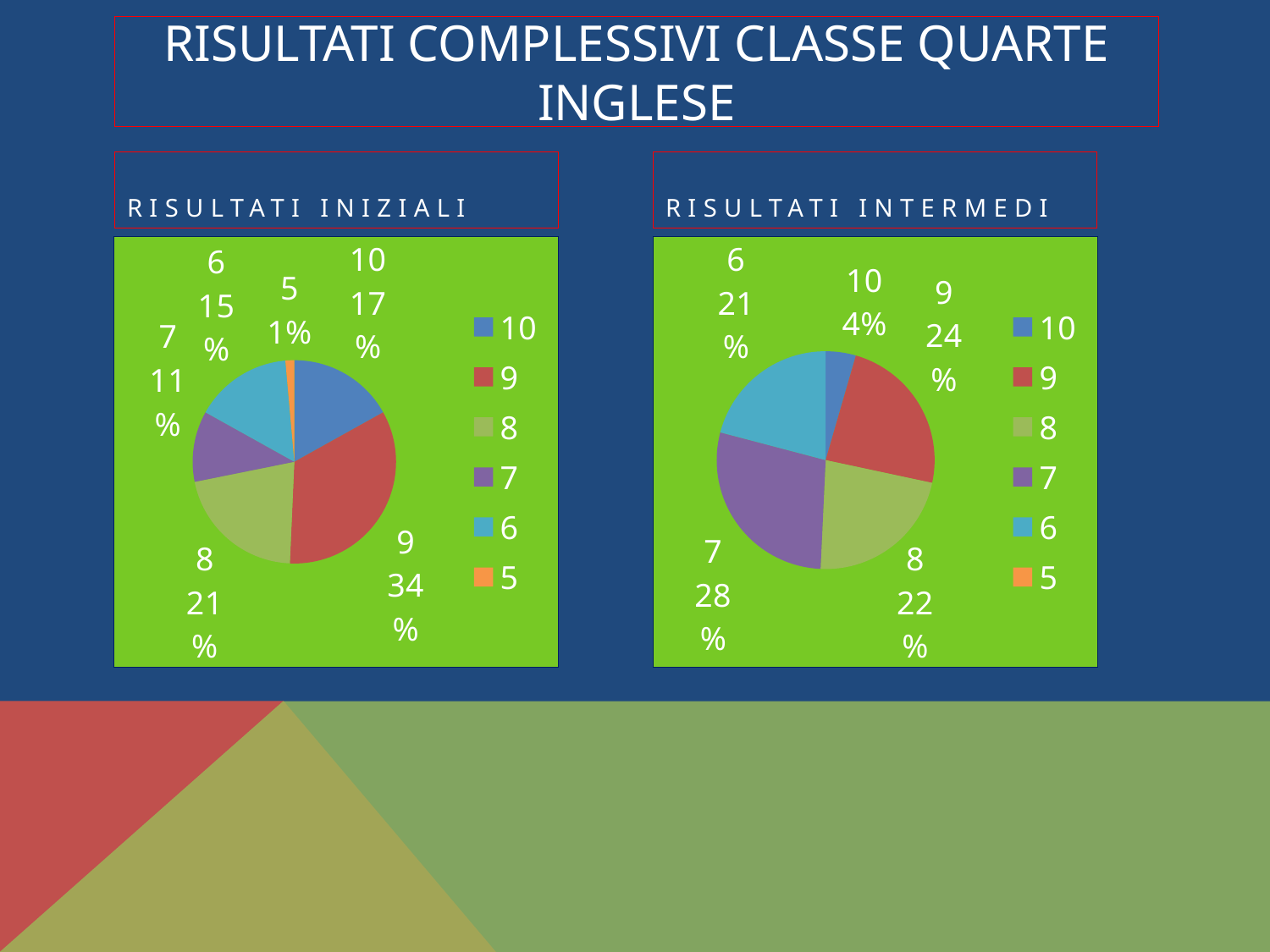
In the RISULTATI INIZIALI chart, what share does grade 5 have? 1% In the RISULTATI INIZIALI chart, what colour is the slice for grade 9? Red In the RISULTATI INIZIALI chart, what share does grade 9 have? 34% What type of chart is the RISULTATI INIZIALI chart? Pie chart In the RISULTATI INIZIALI chart, which grade has the smallest slice? 5 In the RISULTATI INIZIALI chart, which grade has the largest slice? 9 In the RISULTATI INTERMEDI chart, which is larger, the share of grade 9 or the share of grade 6? 9 In the RISULTATI INIZIALI chart, what is the difference between the shares of grade 9 and grade 8? 13% How many entries does the legend of the RISULTATI INTERMEDI chart list? 6 In the RISULTATI INTERMEDI chart, which grade has the largest slice? 7 In the RISULTATI INTERMEDI chart, what share does grade 10 have? 4%